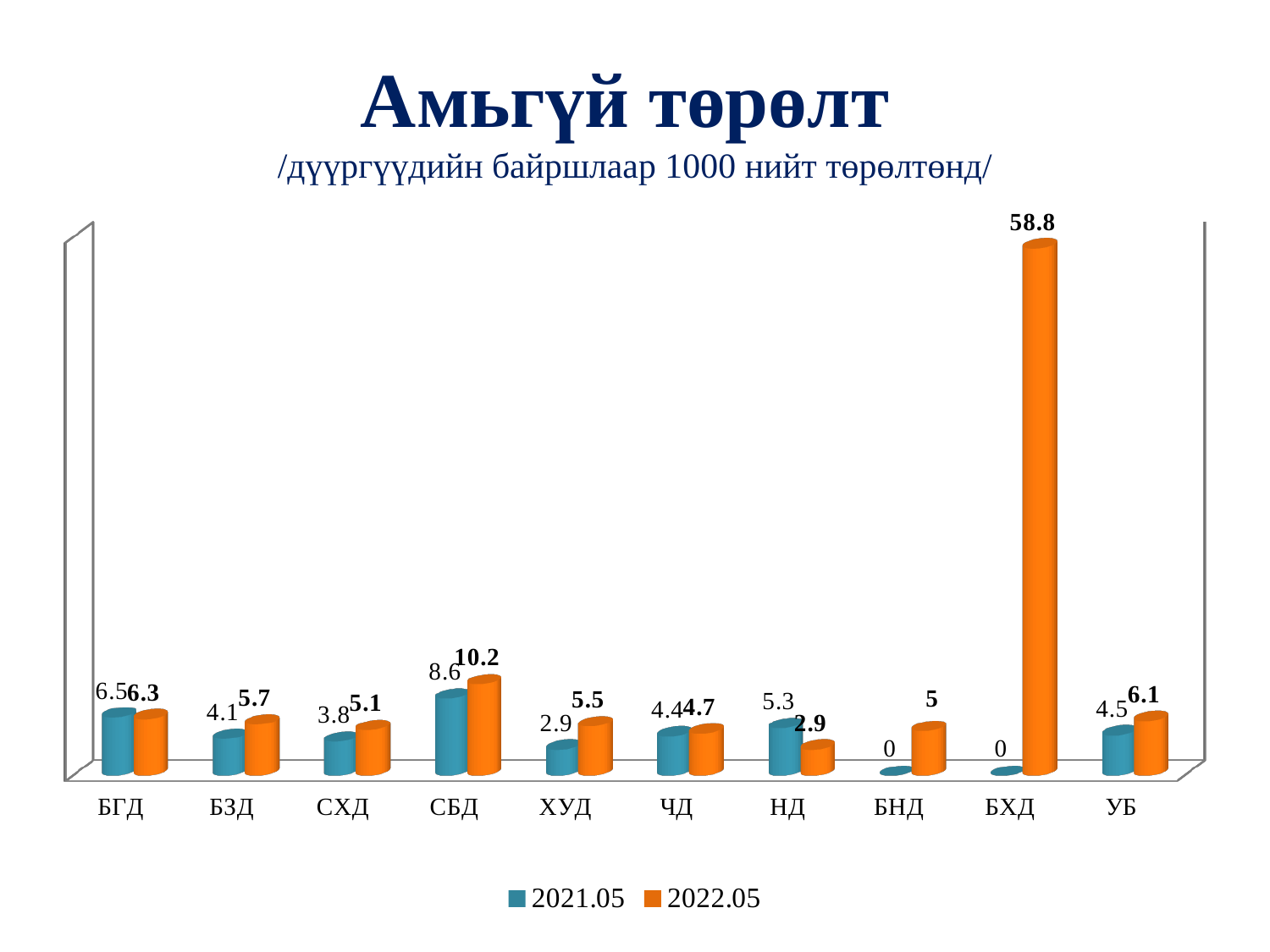
How many series does the legend list? 2 What is the title of the chart on the slide? Амьгүй төрөлт Which category has the highest value in the 2022.05 series? БХД How many categories are shown on the x axis? 10 Which category has the highest value in the 2021.05 series? СБД What is the difference between the 2021.05 and 2022.05 values for НД? 2.4 What is the difference between the 2022.05 and 2021.05 values for СБД? 1.6 What is the value for НД in the 2022.05 series? 2.9 What kind of chart is shown on the slide? Bar chart What is the value for СБД in the 2021.05 series? 8.6 What is the value for БХД in the 2022.05 series? 58.8 For БЗД, which series has the larger value, 2021.05 or 2022.05? 2022.05